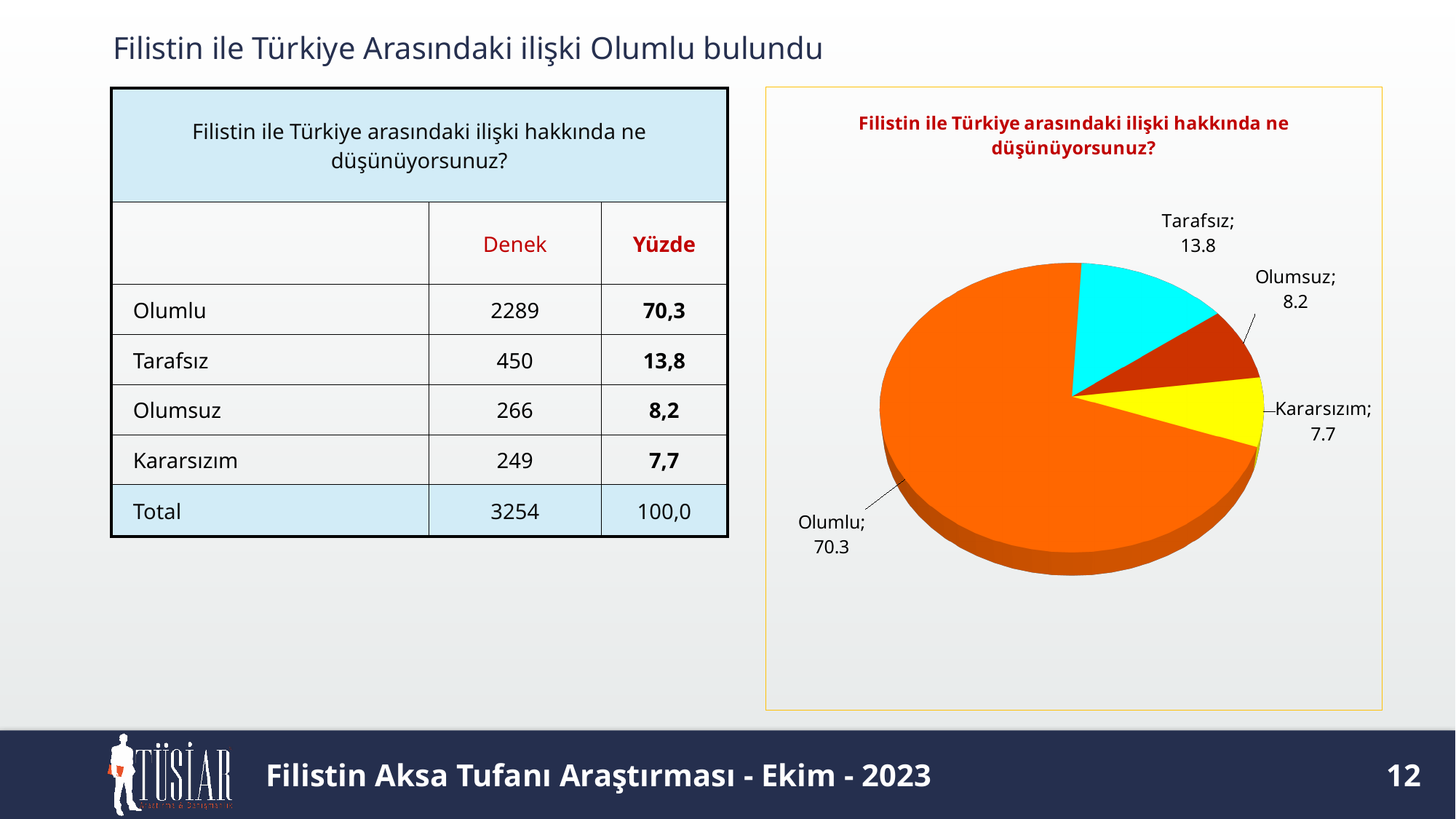
Which is larger in the pie chart, Tarafsız or Olumsuz? Tarafsız Which category has the largest slice in the pie chart? Olumlu Which category has the smallest slice in the pie chart? Kararsızım How many slices does the pie chart have? 4 What kind of chart is shown on the slide? pie chart What is the value for Kararsızım in the pie chart? 7.7 What is the value for Olumlu in the pie chart? 70.3 What is the value for Tarafsız in the pie chart? 13.8 What is the title of the pie chart? Filistin ile Türkiye arasındaki ilişki hakkında ne düşünüyorsunuz? What is the difference between the values for Olumsuz and Kararsızım in the pie chart? 0.5 What is the difference between the values for Olumlu and Tarafsız in the pie chart? 56.5 What is the value for Olumsuz in the pie chart? 8.2